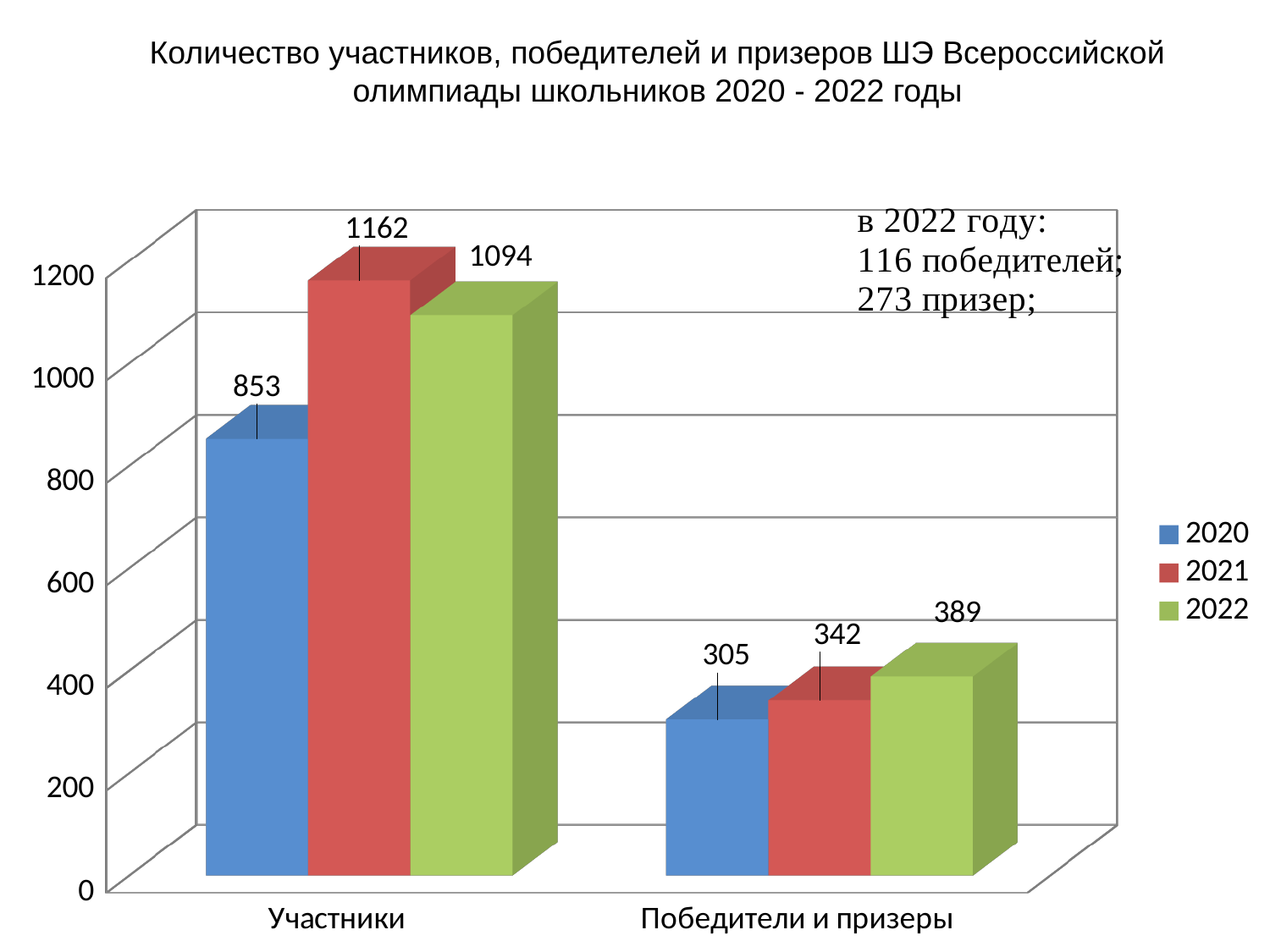
What kind of chart is shown on the slide? Bar chart How many series does the legend list? 3 Which year has the lowest value in the Победители и призеры category? 2020 What is the difference between the 2021 and 2020 values in the Участники category? 309 What is the value for 2022 in the Участники category? 1094 How many categories are shown on the x axis? 2 Do the values in the Победители и призеры category rise or fall from 2020 to 2022? Rise What is the value for 2021 in the Участники category? 1162 Which year has the highest value in the Участники category? 2021 What is the difference between the 2022 and 2021 values in the Победители и призеры category? 47 What is the value for 2020 in the Победители и призеры category? 305 Which is larger: the 2022 value for Участники or the 2020 value for Участники? 2022